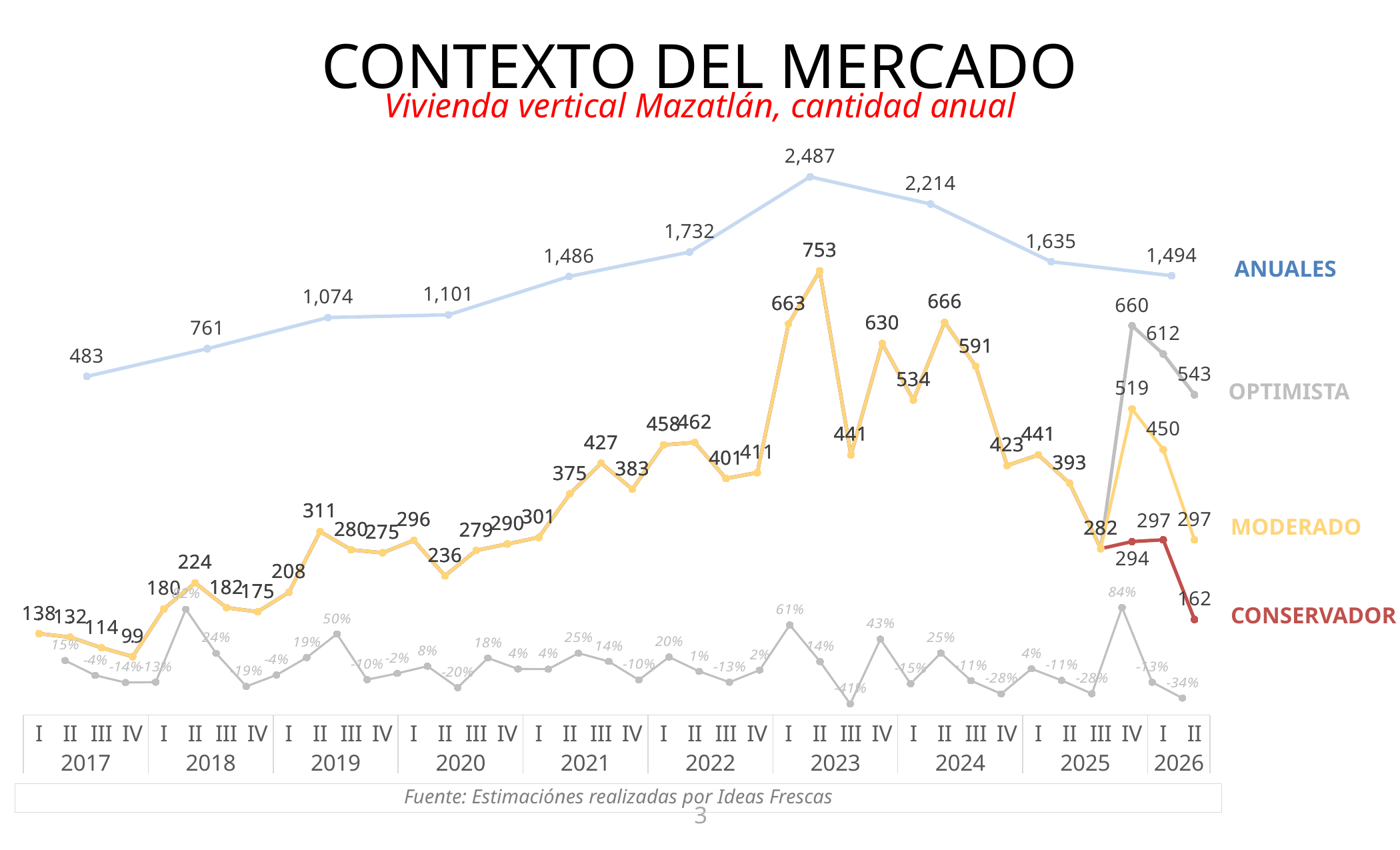
What is the difference between the ANUALES values for 2023 and 2024? 273 What kind of chart is shown on the slide? Line chart What is the quarterly value for quarter II of 2023? 753 Which year has the highest ANUALES value? 2023 Which is larger, the ANUALES value for 2021 or for 2022? 2022 What is the OPTIMISTA value for quarter II of 2026? 543 What is the ANUALES value for 2017? 483 What is the difference between the OPTIMISTA and CONSERVADOR values for quarter II of 2026? 381 What is the subtitle of the chart shown in red? Vivienda vertical Mazatlán, cantidad anual What is the quarterly value for quarter IV of 2017? 99 What is the CONSERVADOR value for quarter II of 2026? 162 What is the ANUALES value for 2023? 2,487